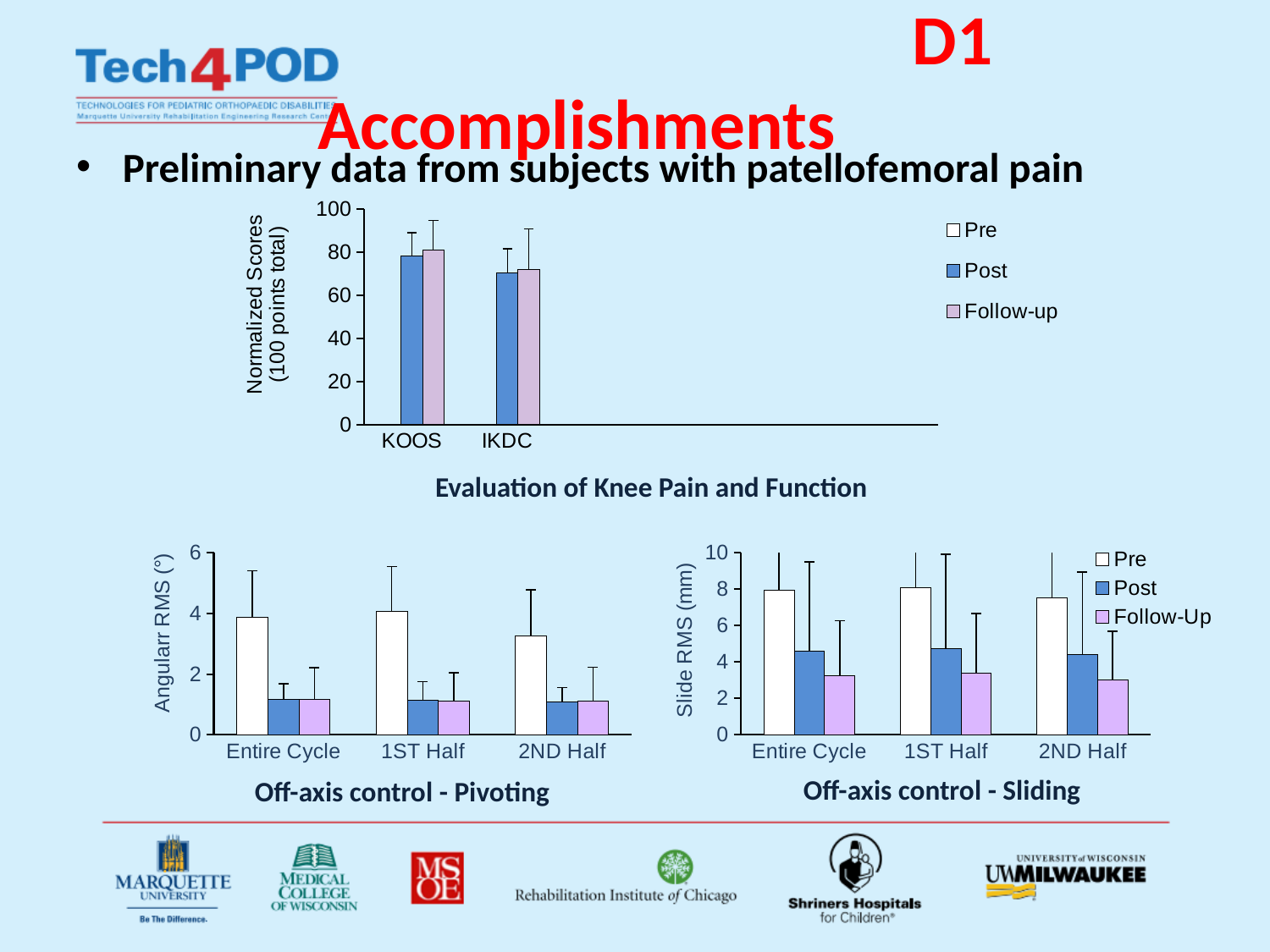
In the 'Evaluation of Knee Pain and Function' chart, is the Post value for IKDC greater or less than 80? less In the 'Evaluation of Knee Pain and Function' chart, is the Post value for KOOS greater or less than 60? greater In the 'Off-axis control - Sliding' chart, which is larger for Entire Cycle, Post or Follow-Up? Post In the 'Off-axis control - Pivoting' chart, is the Post value for 2ND Half greater or less than 2? less In the 'Evaluation of Knee Pain and Function' chart, how many series does the legend list? 3 In the 'Off-axis control - Pivoting' chart, how many categories are shown on the x axis? 3 In the 'Evaluation of Knee Pain and Function' chart, how many categories are shown on the x axis? 2 In the 'Off-axis control - Pivoting' chart, which is larger for Entire Cycle, Pre or Post? Pre In the 'Off-axis control - Sliding' chart, what is the y-axis label? Slide RMS (mm) What kind of chart is 'Off-axis control - Pivoting'? bar chart